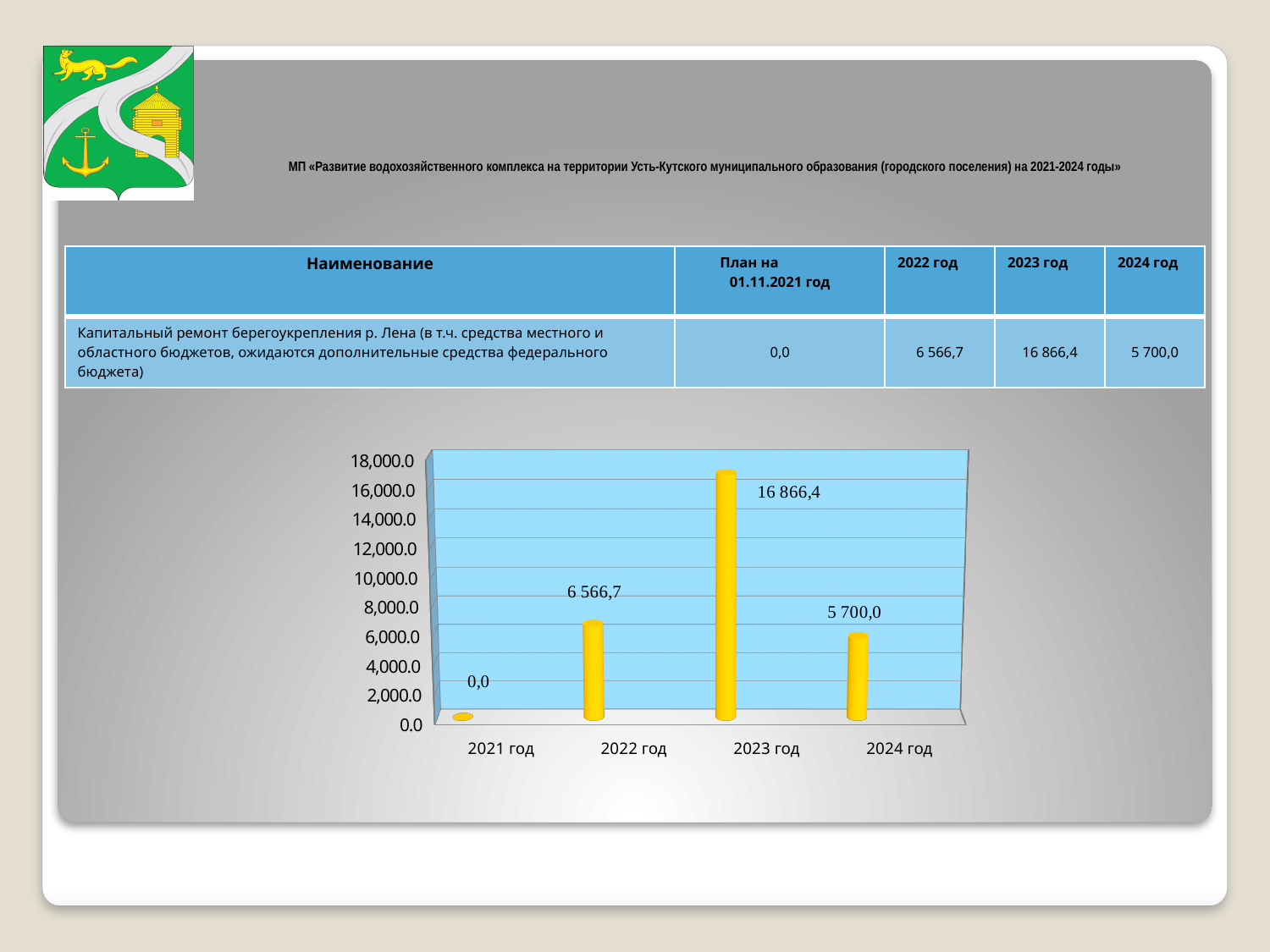
Which year has the lowest value? 2021 год What is the difference between the values for 2022 год and 2024 год? 866,7 What is the value shown for 2024 год? 5 700,0 Is the value for 2023 год greater or less than 16,000.0? greater What is the value shown for 2023 год? 16 866,4 What is the value shown for 2022 год? 6 566,7 What is the difference between the values for 2023 год and 2022 год? 10 299,7 Which is larger, the value for 2022 год or the value for 2024 год? 2022 год What is the value shown for 2021 год? 0,0 How many years are shown on the x axis of the chart? 4 Which year has the highest value? 2023 год What kind of chart is shown on the slide? bar chart